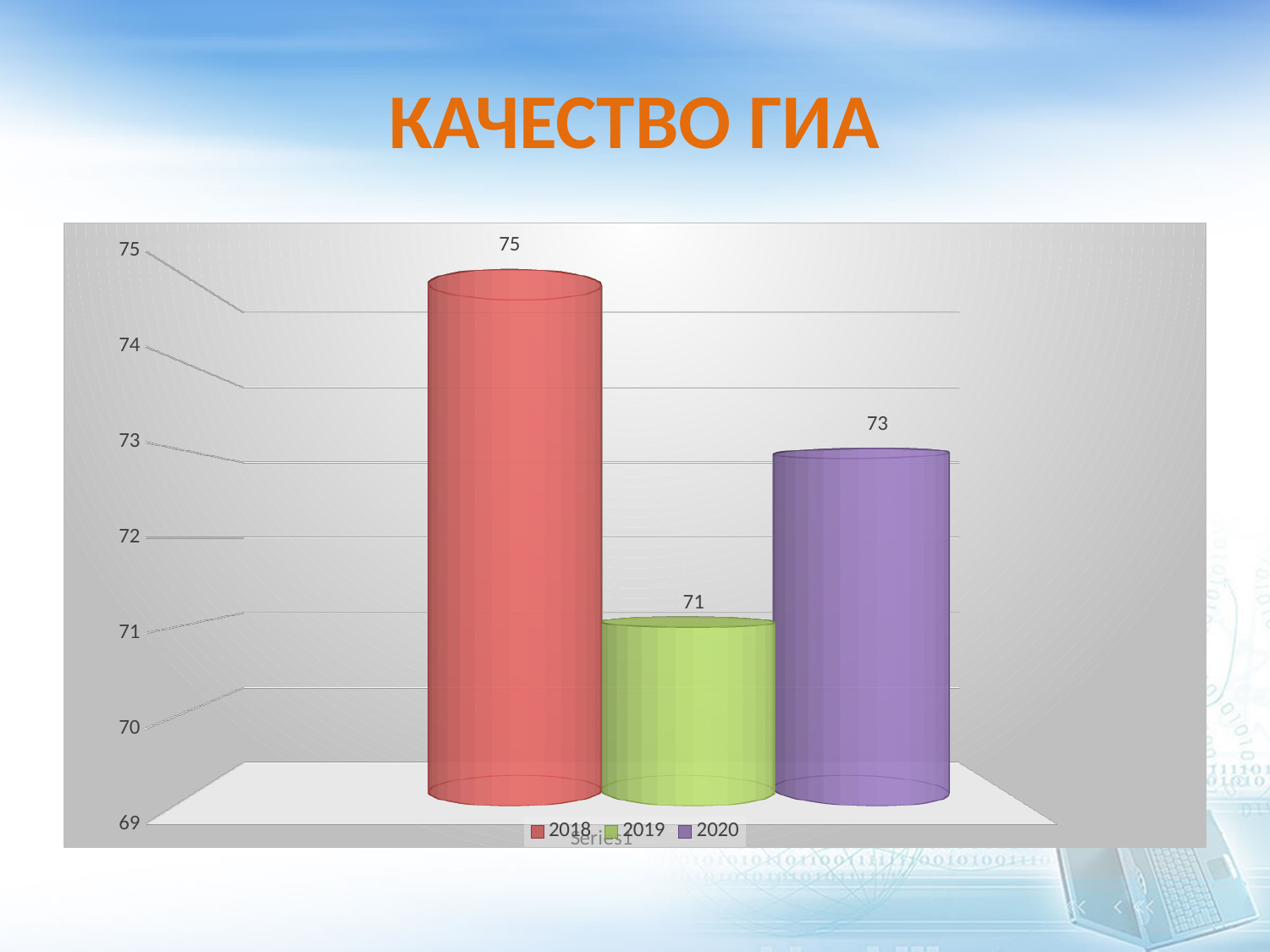
What is the value for 2020? 73 What is the value for 2019? 71 What kind of chart is shown on the slide? bar chart What is the difference between the values for 2018 and 2019? 4 What is the difference between the values for 2020 and 2019? 2 Which year has the highest value? 2018 What is the title of the slide? КАЧЕСТВО ГИА Is the value for 2020 greater or less than 72? greater Which is larger, the value for 2020 or the value for 2019? 2020 What is the value for 2018? 75 Which year has the lowest value? 2019 How many series does the legend list? 3